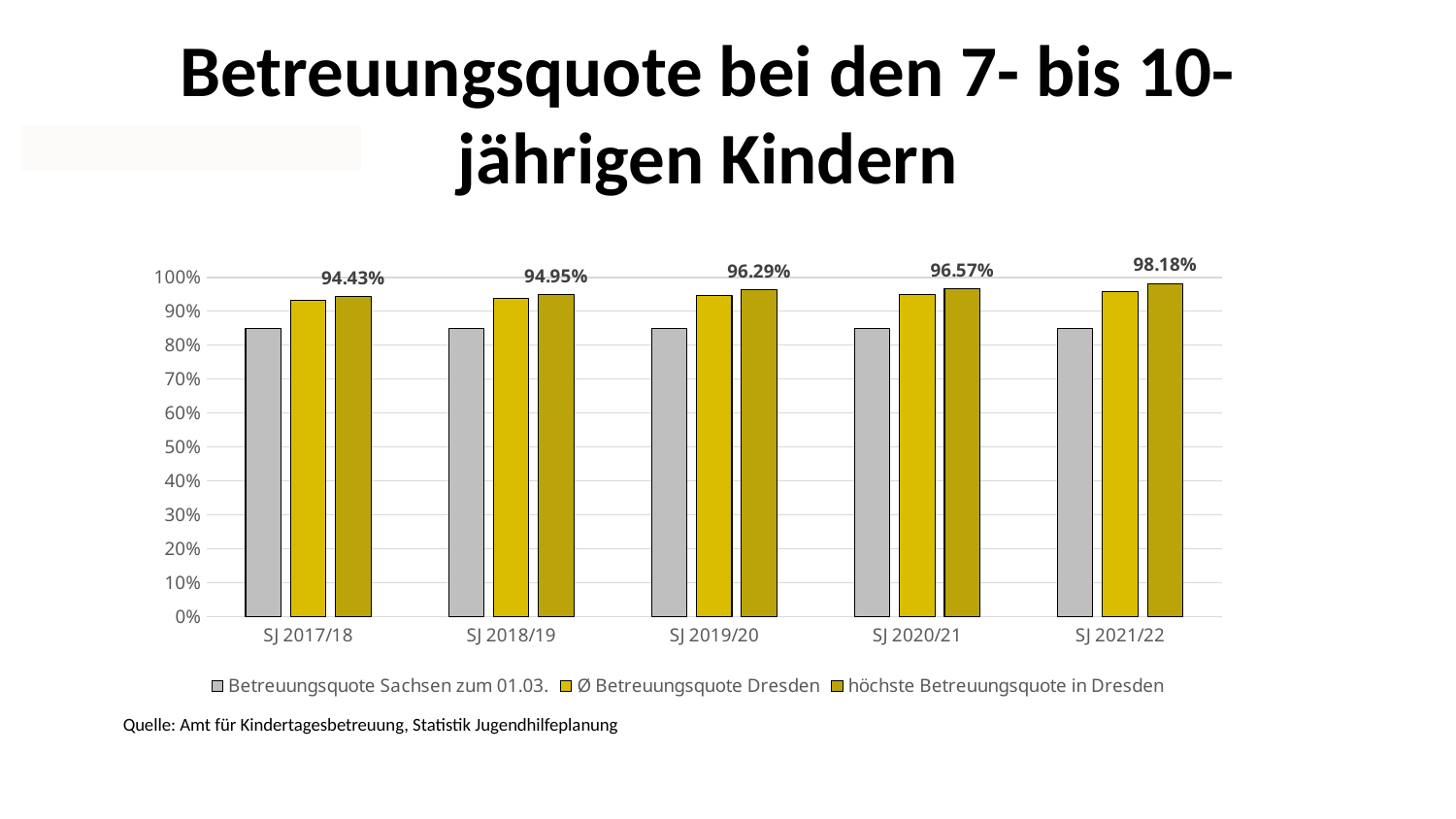
What is the difference in 'höchste Betreuungsquote in Dresden' between SJ 2021/22 and SJ 2017/18? 3.75 percentage points What kind of chart is shown on the slide? bar chart What is the value of 'höchste Betreuungsquote in Dresden' for SJ 2017/18? 94.43% In which school year is the 'höchste Betreuungsquote in Dresden' the highest? SJ 2021/22 Is the value for 'Betreuungsquote Sachsen zum 01.03.' in SJ 2017/18 greater or less than 90%? less In which school year is the 'höchste Betreuungsquote in Dresden' the lowest? SJ 2017/18 How many series does the legend list? 3 What is the value of 'höchste Betreuungsquote in Dresden' for SJ 2021/22? 98.18% Which school year has a higher 'höchste Betreuungsquote in Dresden', SJ 2018/19 or SJ 2020/21? SJ 2020/21 How many school years are shown on the x axis? 5 What is the value of 'höchste Betreuungsquote in Dresden' for SJ 2019/20? 96.29% Does the 'höchste Betreuungsquote in Dresden' rise or fall from SJ 2017/18 to SJ 2021/22? rise